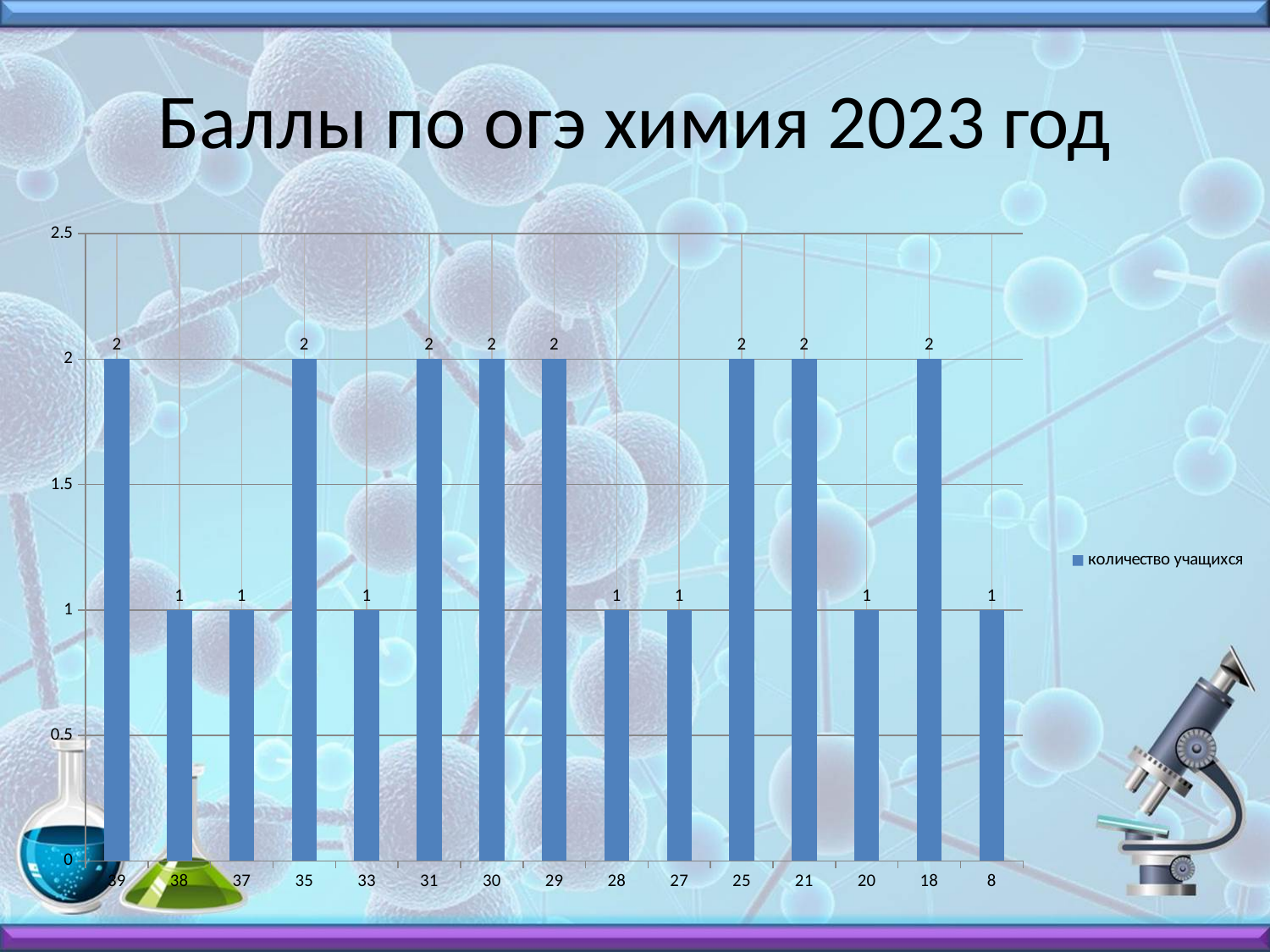
How many bars are plotted in the chart? 15 What is the difference between the value for 25 and the value for 27? 1 How many series does the legend list? 1 Which is larger, the value for 31 or the value for 28? 31 What is the value for category 8? 1 What is the value for category 20? 1 What is the value for category 35? 2 What is the title of the chart? Баллы по огэ химия 2023 год What kind of chart is shown on the slide? bar chart What series does the legend list? количество учащихся Is the value for 30 greater or less than 1.5? greater What is the value for category 38? 1